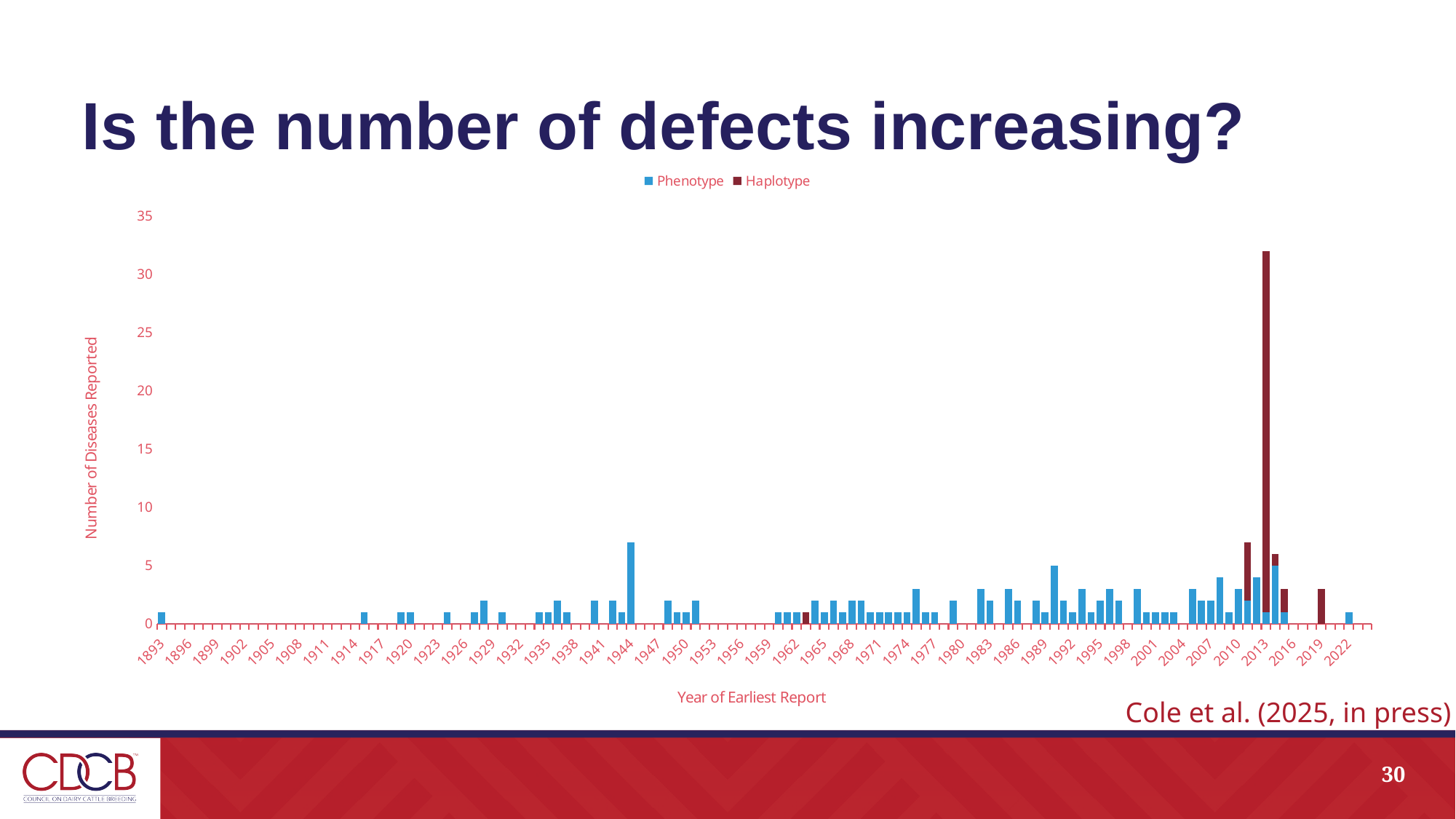
Which series does the tallest bar on the chart belong to? Haplotype Is the value for 2022 greater or less than 5? less What kind of chart is shown on the slide? bar chart What is the title of the vertical axis? Number of Diseases Reported Is the value of the tallest bar on the chart greater or less than 30? greater Is the value for 1893 greater or less than 5? less What are the two series named in the legend? Phenotype and Haplotype How many series does the legend list? 2